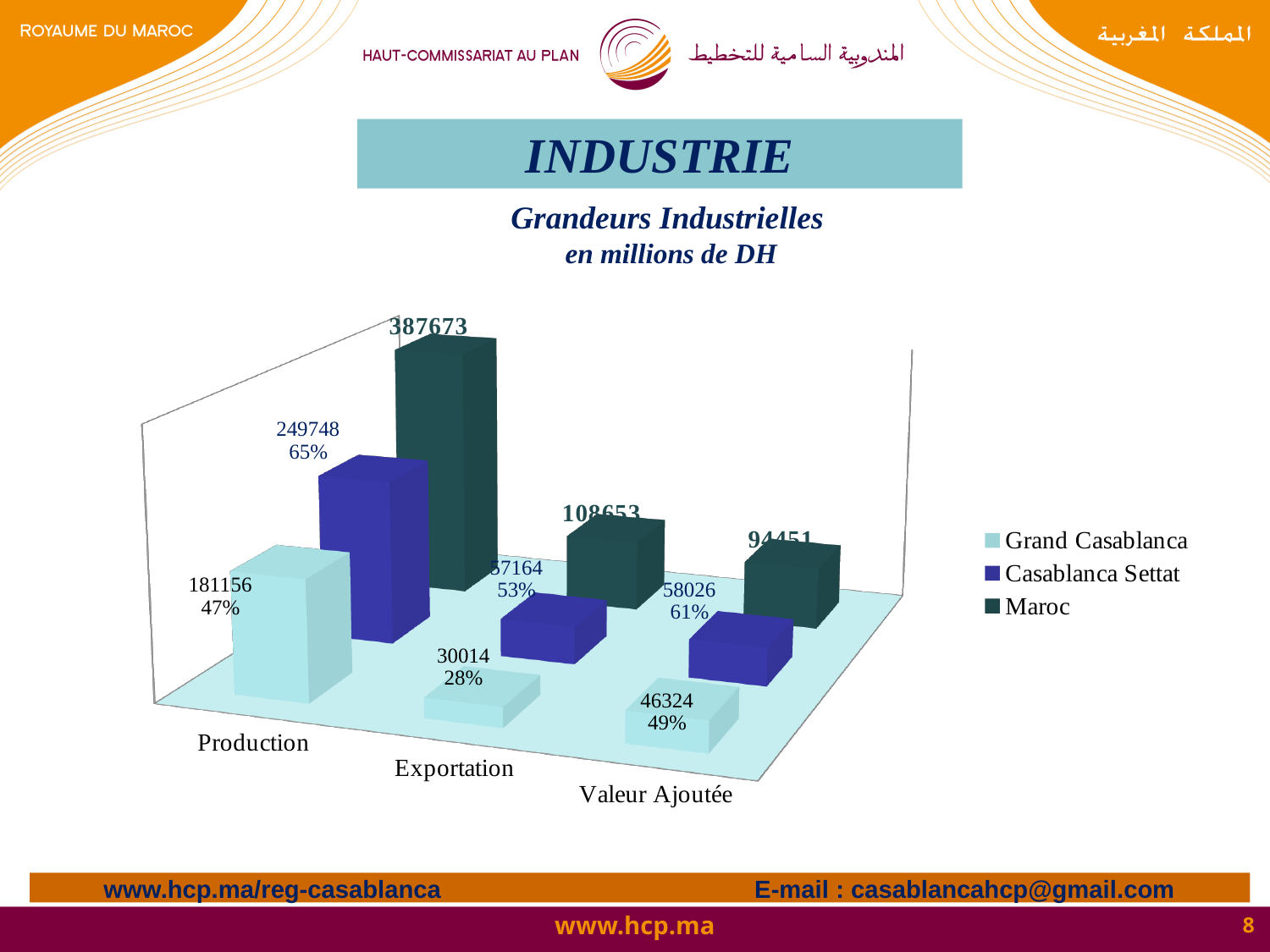
What is the difference between the Production values of Casablanca Settat and Grand Casablanca? 68592 What type of chart is shown on the slide? bar chart What is the Production value for Grand Casablanca? 181156 Which category has the highest value for Maroc? Production Which is larger for Valeur Ajoutée: Casablanca Settat or Grand Casablanca? Casablanca Settat What is the Production value for Maroc? 387673 What is the Valeur Ajoutée value for Maroc? 94451 What is the Exportation value for Casablanca Settat? 57164 Which category has the lowest value for Grand Casablanca? Exportation How many series does the legend list? 3 What percentage is shown for Grand Casablanca under Exportation? 28% How many categories are shown on the x axis of the chart? 3